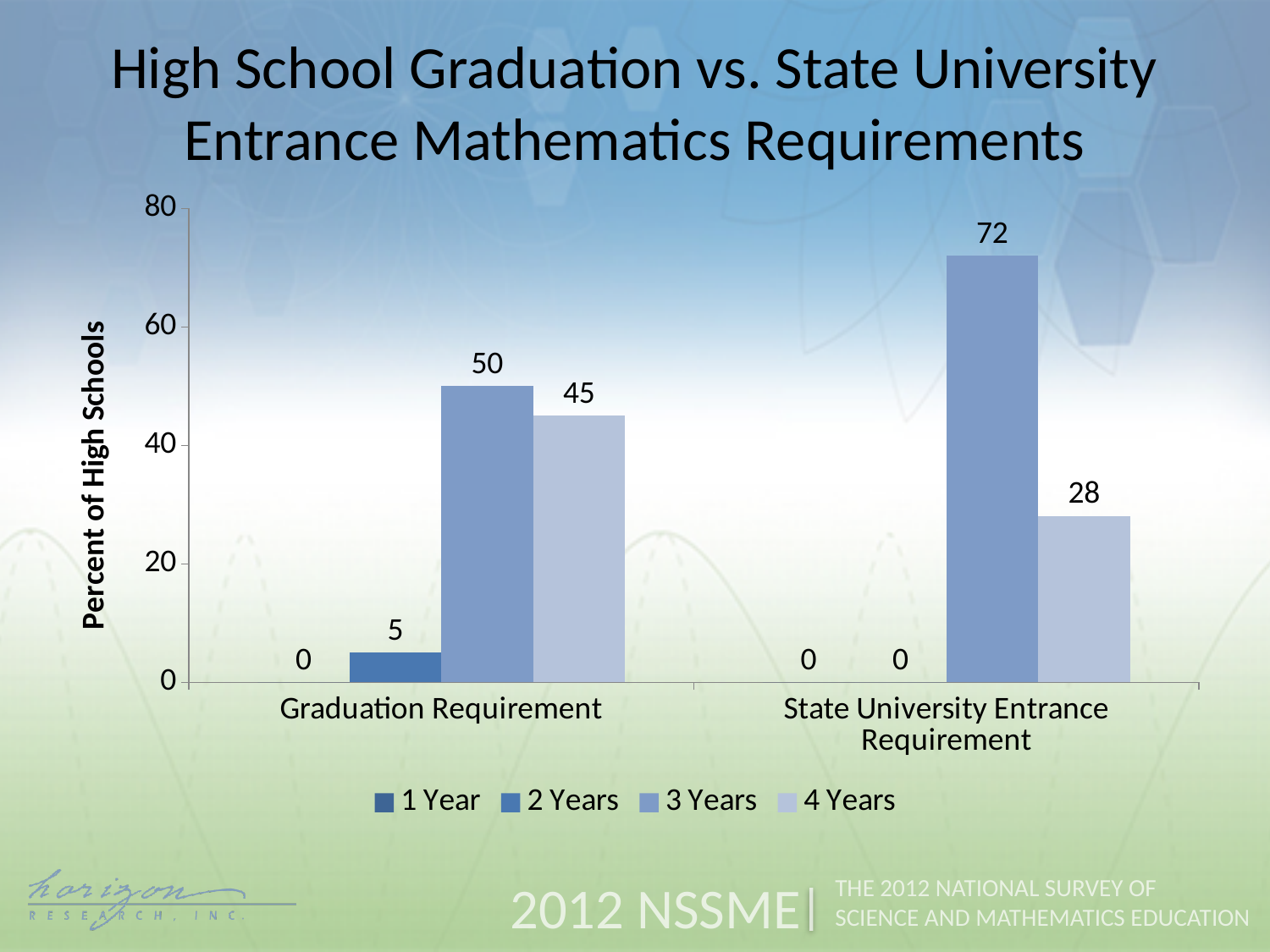
How many series does the legend list? 4 What is the value for 4 Years under State University Entrance Requirement? 28 What is the value for 2 Years under State University Entrance Requirement? 0 What is the difference between the 3 Years values for State University Entrance Requirement and Graduation Requirement? 22 How many categories are shown on the x axis? 2 Which series has the highest value under State University Entrance Requirement? 3 Years What is the value for 3 Years under Graduation Requirement? 50 What kind of chart is shown on the slide? bar chart Which is larger: the 4 Years value for Graduation Requirement or the 4 Years value for State University Entrance Requirement? Graduation Requirement What is the difference between the 3 Years and 4 Years values under Graduation Requirement? 5 What is the value for 2 Years under Graduation Requirement? 5 What is the label of the y axis? Percent of High Schools